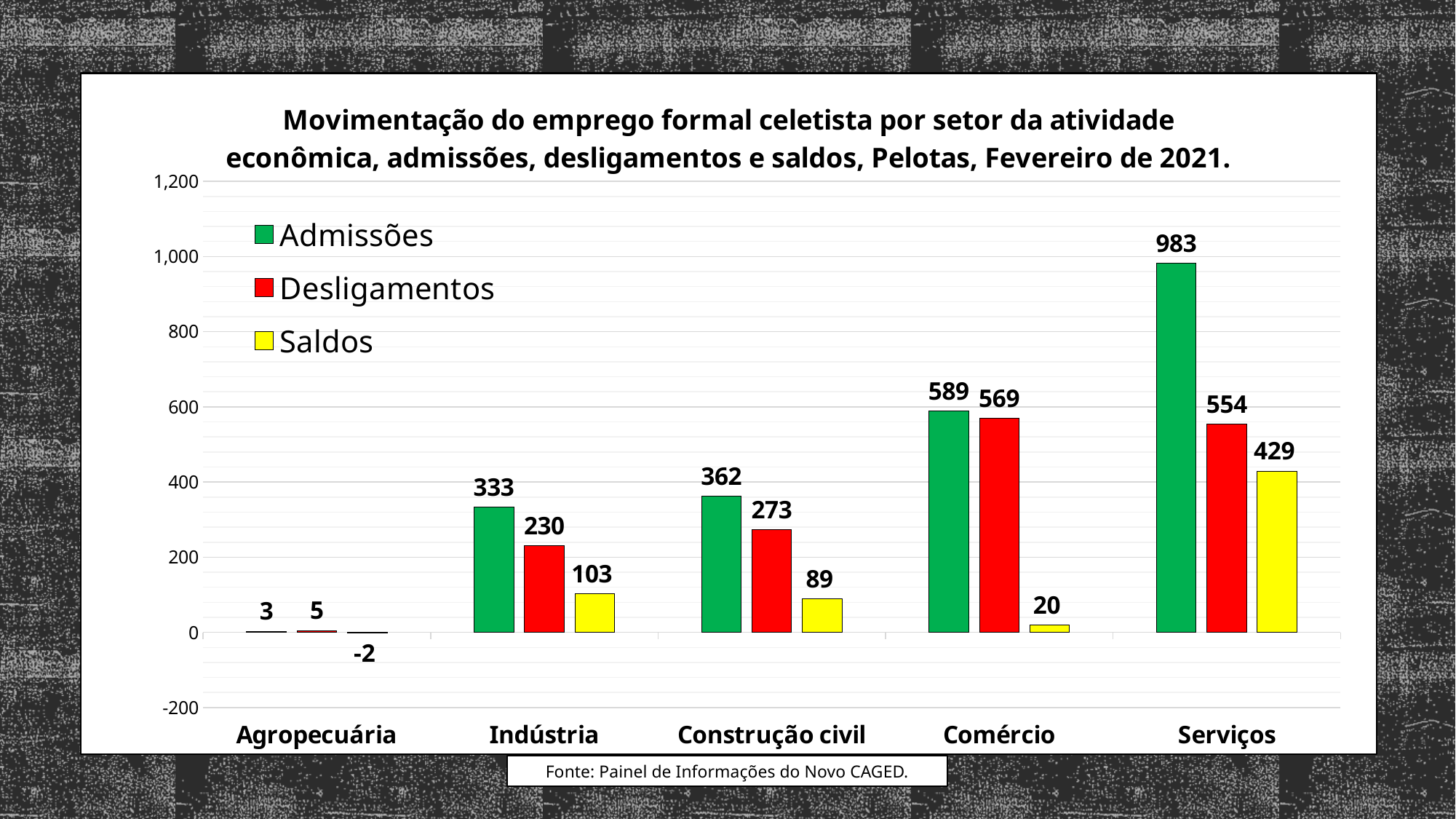
Which is larger for Construção civil: Admissões or Desligamentos? Admissões Is the Desligamentos value for Serviços greater or less than 400? greater What is the Saldos value for Agropecuária? -2 How many sectors are shown on the x axis? 5 Which sector has the highest Admissões value? Serviços What is the difference between Admissões and Desligamentos for Comércio? 20 What kind of chart is shown on the slide? Bar chart How many series does the legend list? 3 Which sector has the lowest Saldos value? Agropecuária What is the Admissões value for Serviços? 983 What is the Desligamentos value for Indústria? 230 Which colour represents Saldos in the legend? Yellow